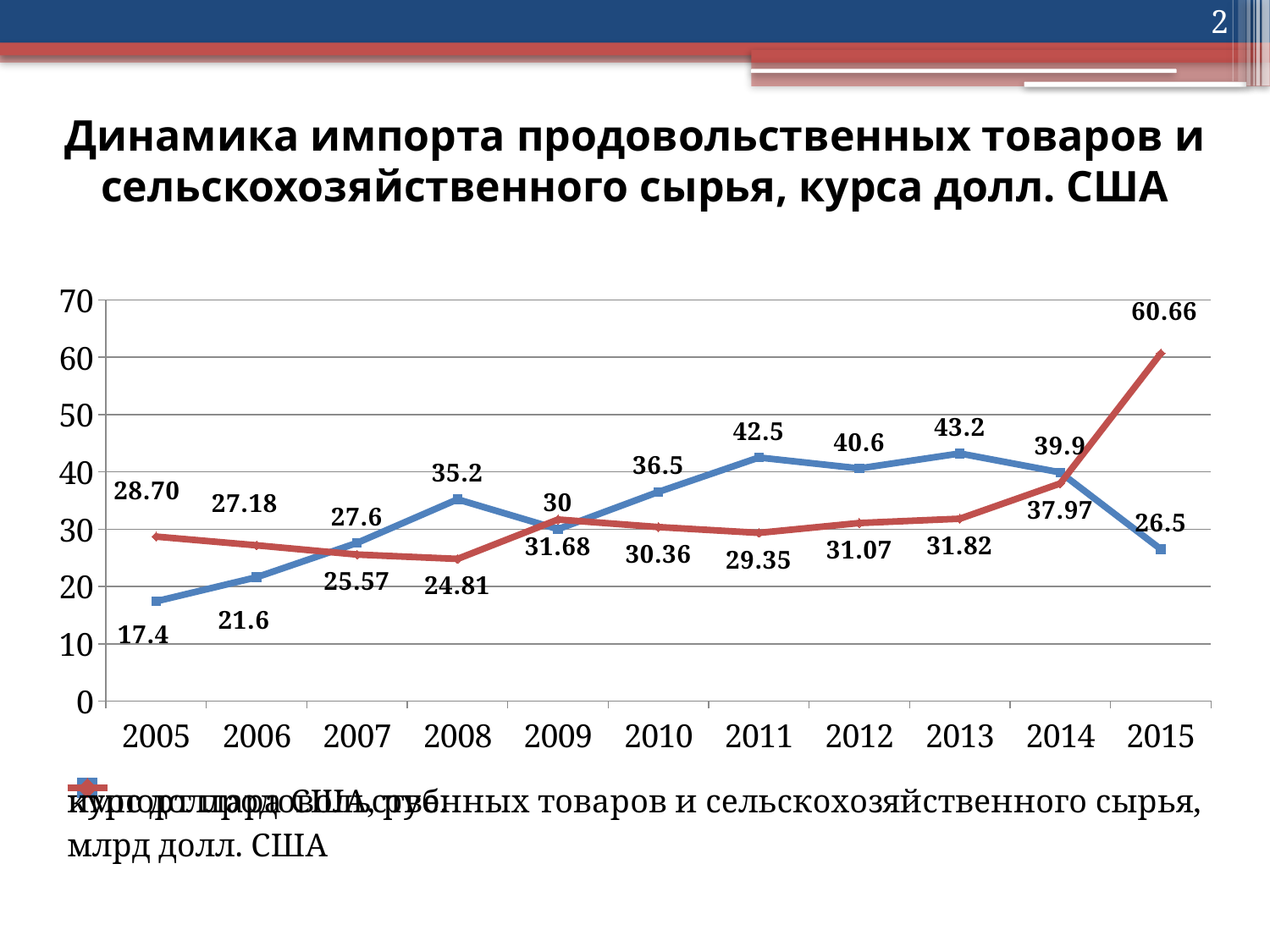
What is the value of the red line in 2015? 60.66 Which line has the higher value in 2011, the blue line or the red line? the blue line How many data series are plotted in the chart? 2 In which year does the red line have its lowest value? 2008 What is the value of the blue line in 2005? 17.4 What is the value of the red line in 2008? 24.81 In which year does the blue line reach its highest value? 2013 What is the value of the blue line in 2013? 43.2 How many years are plotted along the x axis of the chart? 11 What type of chart is shown on the slide? line chart What is the difference between the red line's values in 2015 and 2014? 22.69 Does the blue line rise or fall from 2014 to 2015? fall